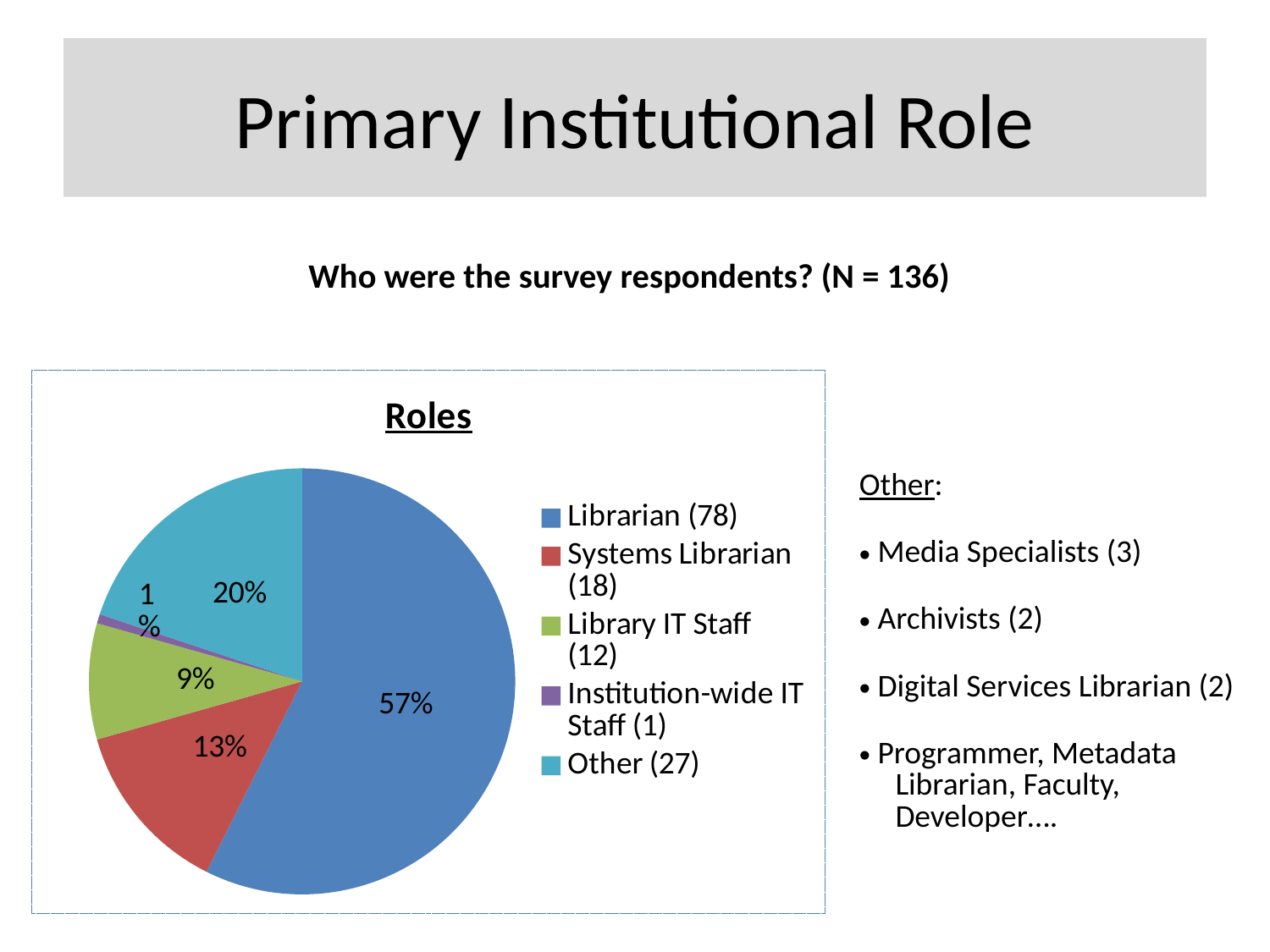
What is the title of the chart? Roles Which category has the largest slice of the pie? Librarian (78) Which category has the smallest slice of the pie? Institution-wide IT Staff (1) What percentage of the pie does the Institution-wide IT Staff (1) slice represent? 1% How many slices does the pie chart have? 5 What is the difference in percentage points between the Librarian (78) slice and the Other (27) slice? 37 What percentage of the pie does the Librarian (78) slice represent? 57% What percentage of the pie does the Systems Librarian (18) slice represent? 13% Which slice is larger, Other (27) or Systems Librarian (18)? Other (27) What kind of chart is shown on the slide? pie chart